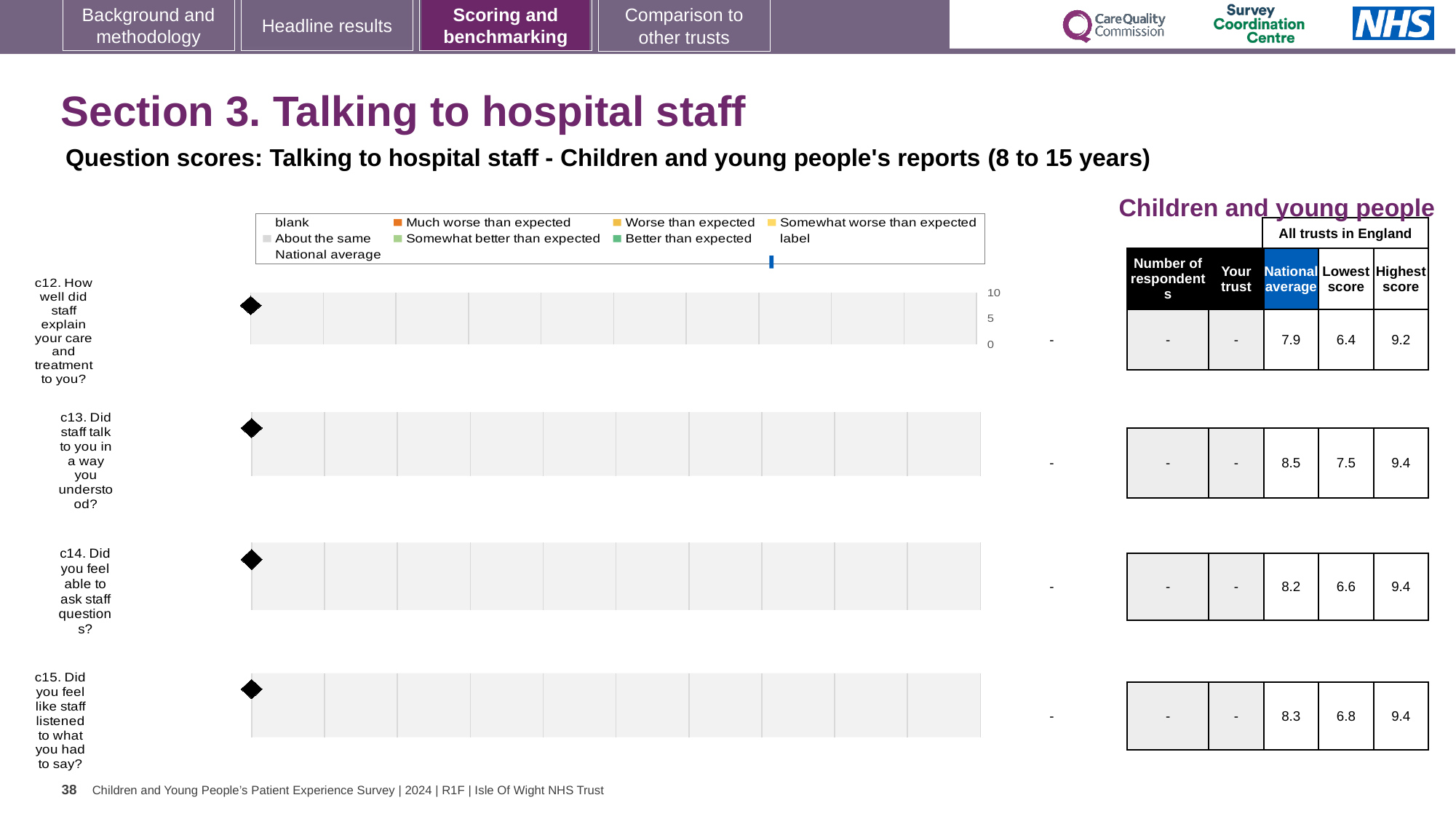
How many question charts (c12 to c15) are shown on the slide? 4 Which question (c12 to c15) has the highest National average score in the table? c13 What kind of chart is used for question c12 on this slide? bar chart What is the highest tick value shown on the axis of the c12 chart? 10 For question c14, what is the difference between the Highest score and the Lowest score in the table? 2.8 In the table next to the c15 chart, what is the Lowest score across all trusts in England? 6.8 In the legend, what colour marks 'Much worse than expected'? orange Which question (c12 to c15) has the lowest National average score in the table? c12 What value is shown for 'Your trust' for question c12 in the table? - In the table next to the c13 chart, what is the National average score? 8.5 Which has the larger National average score in the table, c14 or c15? c15 In the table next to the c12 chart, what is the Highest score across all trusts in England? 9.2